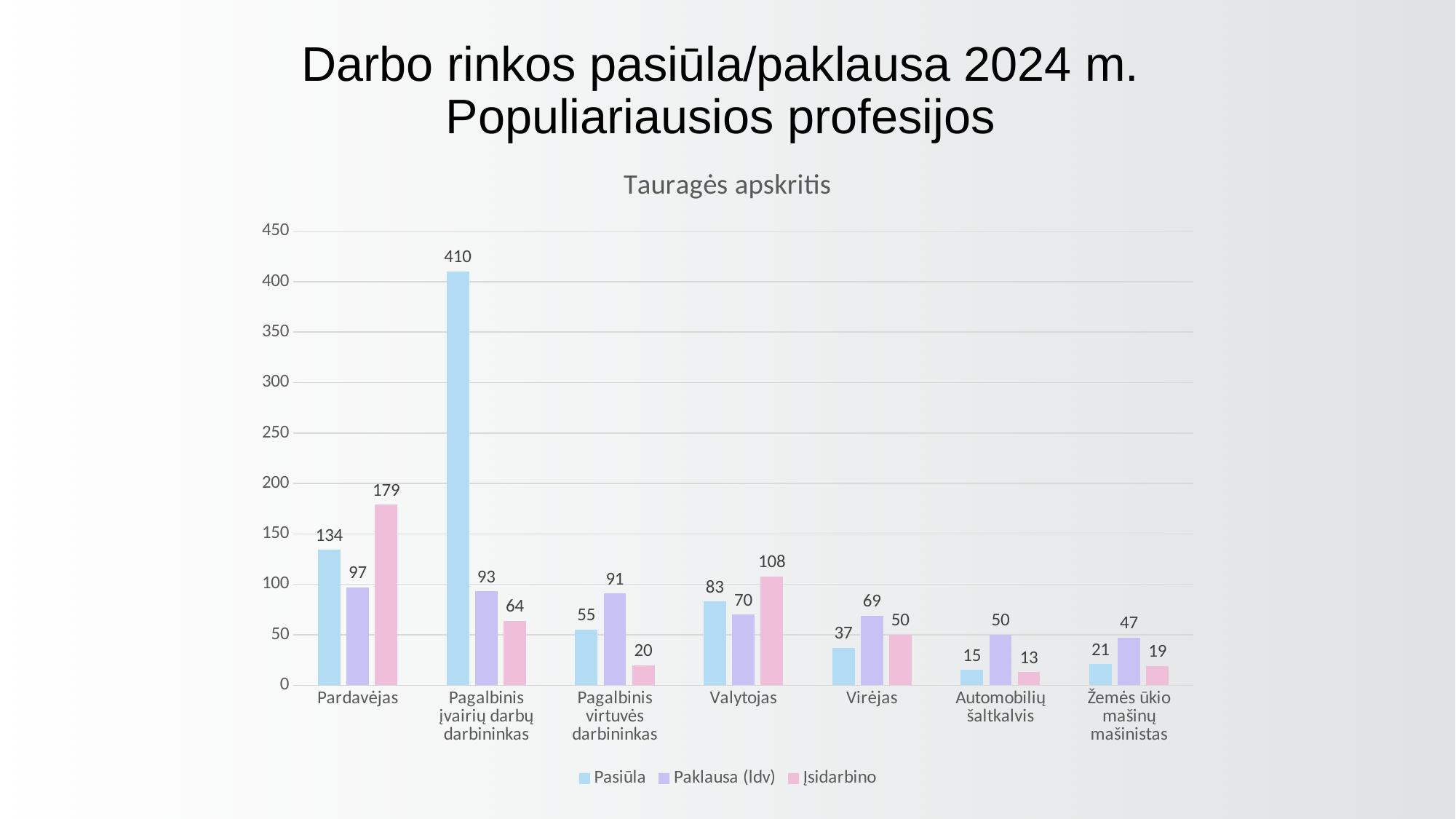
What is the difference between the Įsidarbino values for Valytojas and Pagalbinis virtuvės darbininkas? 88 How many professions are shown on the x axis? 7 Which profession has the highest Pasiūla value? Pagalbinis įvairių darbų darbininkas Which profession has the lowest Įsidarbino value? Automobilių šaltkalvis What is the Paklausa (ldv) value for Valytojas? 70 What is the chart's title? Tauragės apskritis What is the Įsidarbino value for Pardavėjas? 179 How many series does the legend list? 3 Which is larger for Virėjas: the Paklausa (ldv) value or the Įsidarbino value? Paklausa (ldv) What is the Pasiūla value for Pagalbinis įvairių darbų darbininkas? 410 What is the difference between the Pasiūla and Paklausa (ldv) values for Pardavėjas? 37 What kind of chart is shown on the slide? Bar chart